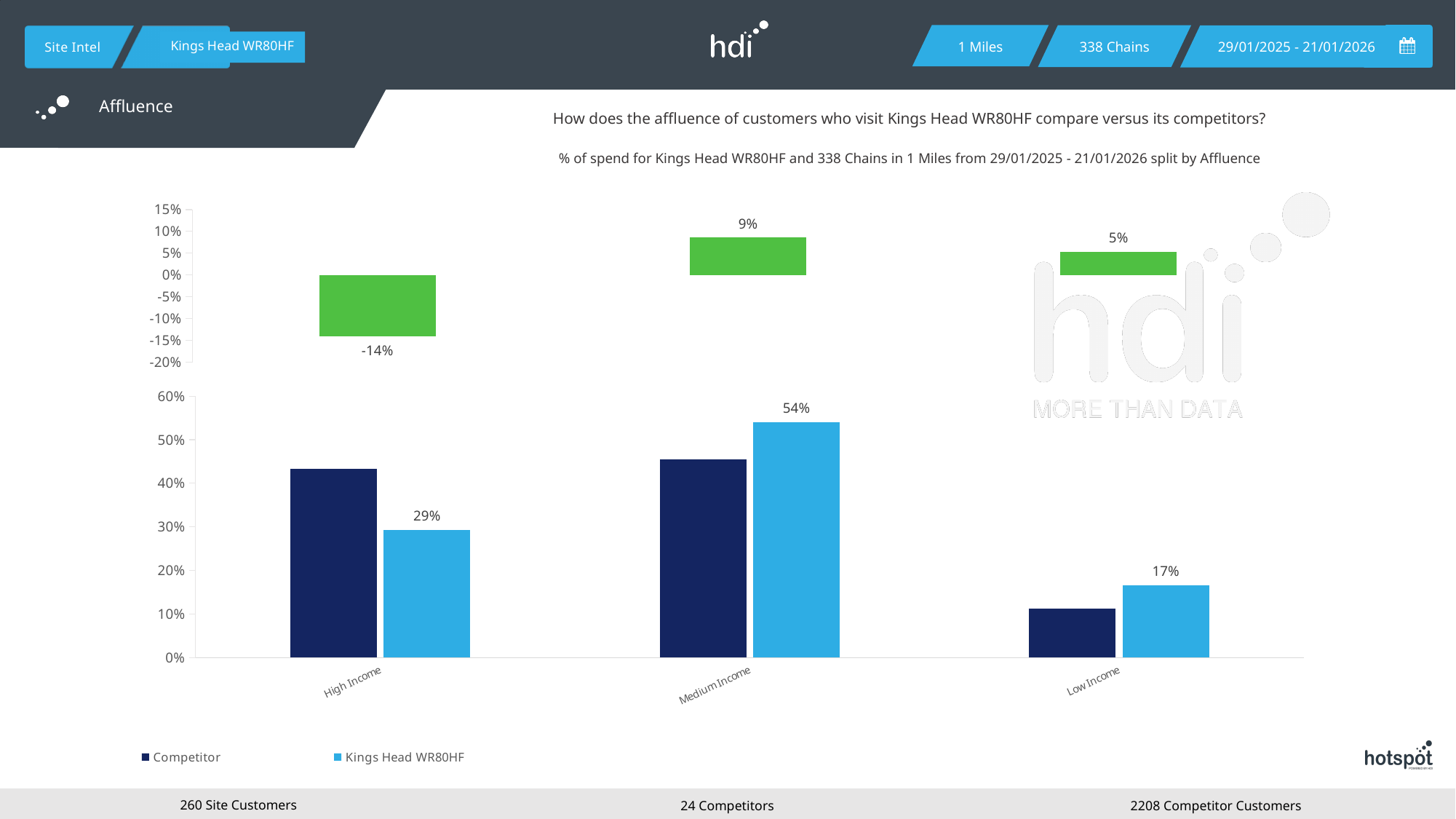
In the top chart, what is the value shown for Medium Income? 9% In the top chart, which category has the lowest value? High Income What kind of chart is the bottom chart? Bar chart In the bottom chart, what is the value for Kings Head WR80HF in the Medium Income category? 54% How many series does the legend of the bottom chart list? 2 In the bottom chart, which category has the highest value for Kings Head WR80HF? Medium Income In the bottom chart, which is larger for Low Income: Competitor or Kings Head WR80HF? Kings Head WR80HF In the bottom chart, is the Competitor value for High Income greater or less than 40%? greater In the top chart, what is the value shown for High Income? -14% In the bottom chart, what is the value for Kings Head WR80HF in the Low Income category? 17% In the bottom chart, what is the value for Kings Head WR80HF in the High Income category? 29% In the bottom chart, what is the difference between the Kings Head WR80HF values for Medium Income and Low Income? 37%